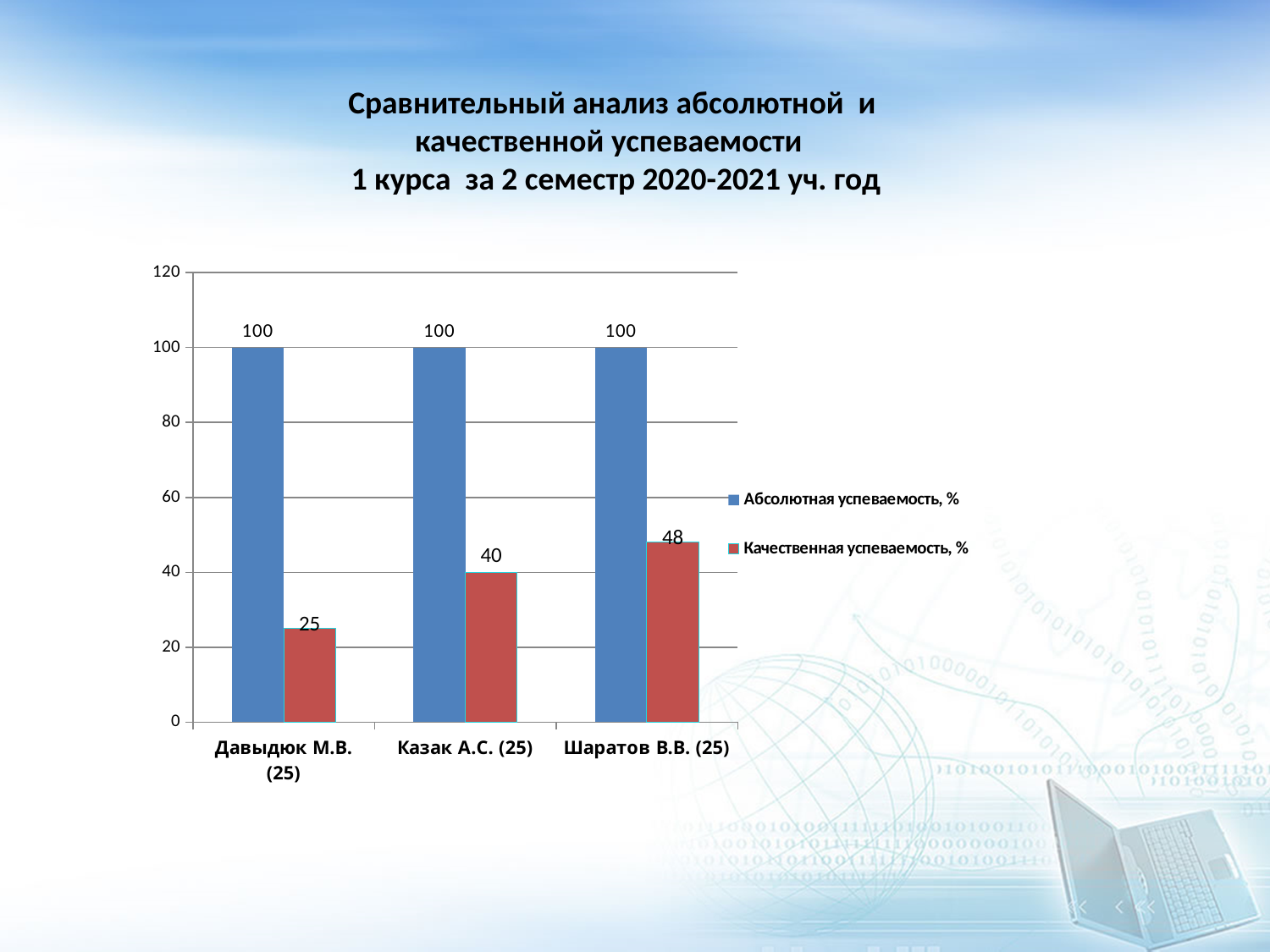
How many series does the legend list? 2 What is the value of Качественная успеваемость, % for Шаратов В.В. (25)? 48 What is the value of Качественная успеваемость, % for Казак А.С. (25)? 40 Which category has the highest value for Качественная успеваемость, %? Шаратов В.В. (25) What kind of chart is shown on the slide? Bar chart Which category has the lowest value for Качественная успеваемость, %? Давыдюк М.В. (25) What is the value of Качественная успеваемость, % for Давыдюк М.В. (25)? 25 Which is larger: Качественная успеваемость, % for Казак А.С. (25) or for Давыдюк М.В. (25)? Казак А.С. (25) What is the difference between Абсолютная успеваемость, % and Качественная успеваемость, % for Давыдюк М.В. (25)? 75 What is the difference in Качественная успеваемость, % between Шаратов В.В. (25) and Казак А.С. (25)? 8 How many categories are shown on the x axis? 3 What is the value of Абсолютная успеваемость, % for Казак А.С. (25)? 100